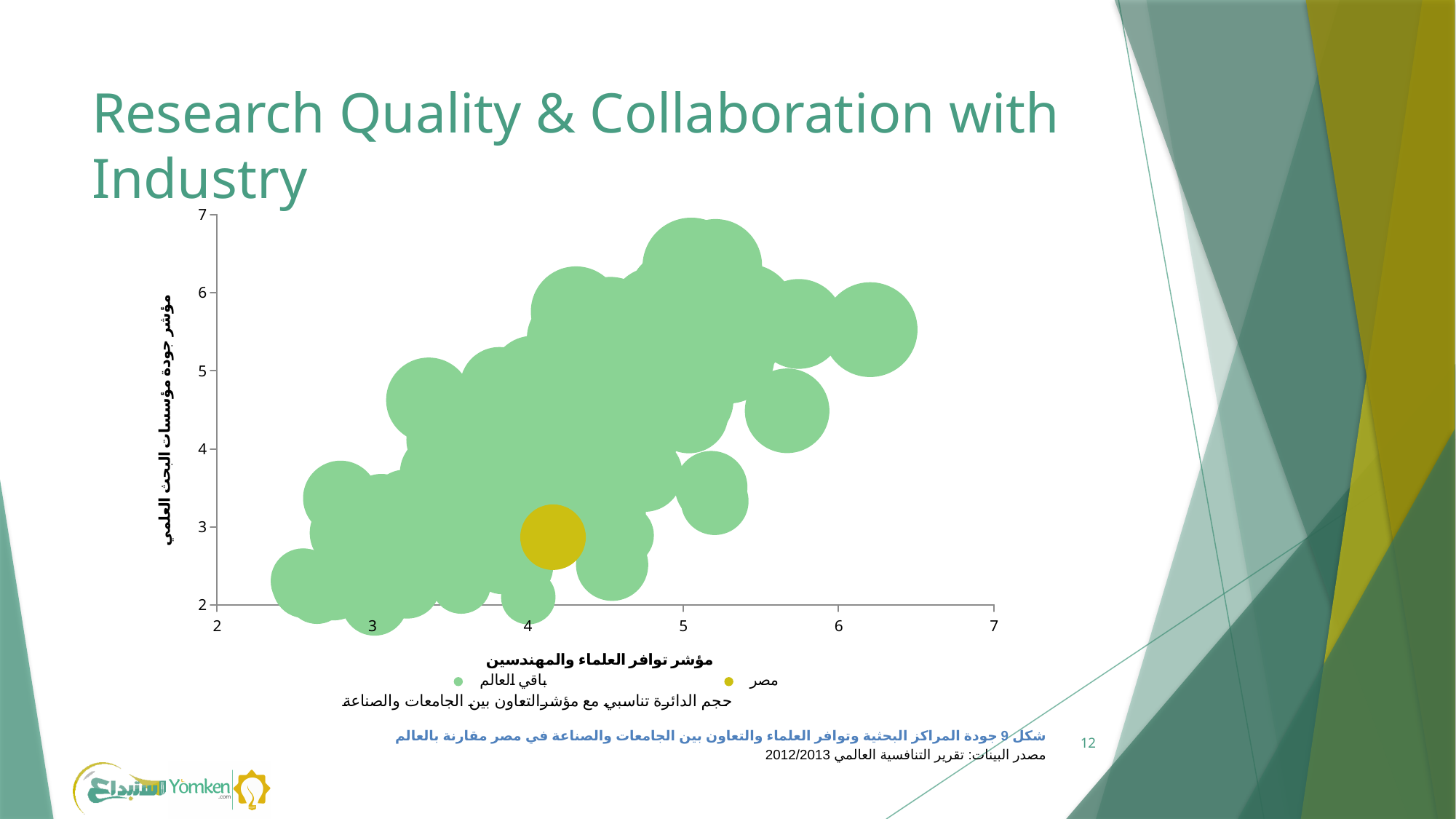
Which series in the legend is shown in green? باقي العالم What kind of chart is shown on the slide? Bubble chart Is the value on the vertical axis for مصر (Egypt) greater or less than 2? greater Which series in the legend is shown in yellow? مصر As the horizontal-axis value increases, do the bubbles for باقي العالم generally rise or fall on the vertical axis? rise Is the value on the vertical axis for مصر (Egypt) greater or less than 4? less What is the highest tick value shown on the horizontal axis? 7 How many series does the chart legend list? 2 Is the value on the horizontal axis for مصر (Egypt) greater or less than 5? less What is the lowest tick value shown on the vertical axis? 2